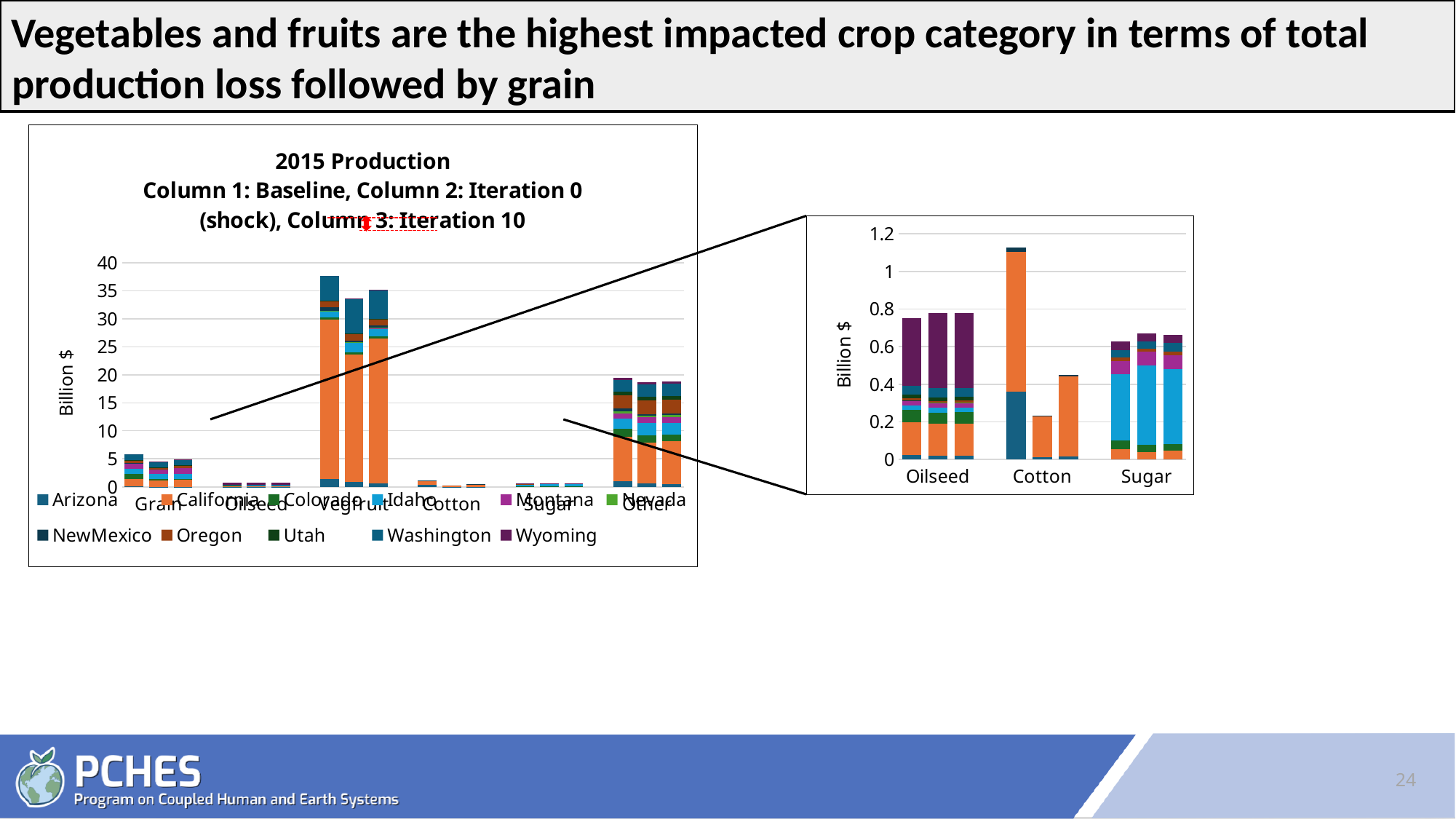
In the '2015 Production' chart on the left, which crop category has the tallest bars? Vegfruit What type of chart is the '2015 Production' chart on the left? Stacked bar chart How many states does the legend of the '2015 Production' chart list? 11 In the '2015 Production' chart on the left, which is larger: the baseline bar for Grain or the baseline bar for Other? Other In the zoomed-in chart on the right, is the first (baseline) bar for Cotton greater or less than 1 billion $? greater In the zoomed-in chart on the right, which bar is the tallest? Cotton baseline (first bar) What is the y-axis label of the '2015 Production' chart on the left? Billion $ In the '2015 Production' chart on the left, how many crop categories are shown on the x axis? 6 In the '2015 Production' chart on the left, is the baseline (first) bar for Other greater or less than 20 billion $? less In the zoomed-in chart on the right, which is larger: the first bar for Oilseed or the first bar for Sugar? Oilseed In the zoomed-in chart on the right, how many crop categories are shown? 3 In the '2015 Production' chart on the left, is the baseline (first) bar for Vegfruit greater or less than 35 billion $? greater